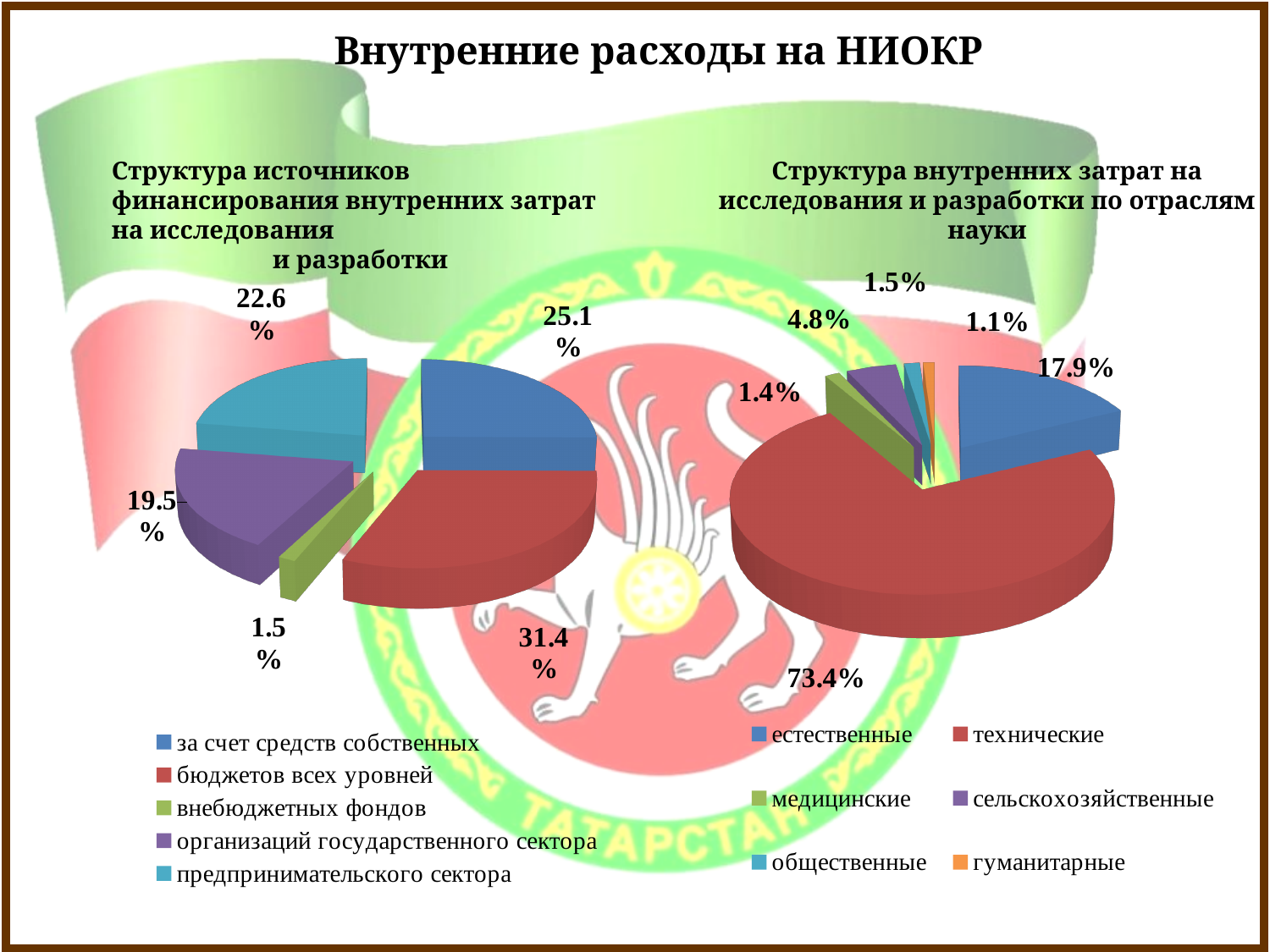
On the left chart (Структура источников финансирования), what is the difference between the shares of 'за счет средств собственных' and 'организаций государственного сектора'? 5.6% On the right chart (по отраслям науки), what share is attributed to 'естественные'? 17.9% On the right chart (по отраслям науки), which branch of science has the largest share? технические On the right chart (по отраслям науки), how many categories does the legend list? 6 On the left chart (Структура источников финансирования), which source has the smallest share? внебюджетных фондов What type of chart is used for both charts on the slide? Pie chart On the left chart (Структура источников финансирования), what share is attributed to 'бюджетов всех уровней'? 31.4% On the left chart (Структура источников финансирования), how many categories does the legend list? 5 On the right chart (по отраслям науки), which is larger: the share for 'сельскохозяйственные' or for 'медицинские'? сельскохозяйственные On the left chart (Структура источников финансирования), which source has the largest share? бюджетов всех уровней On the right chart (по отраслям науки), what share is attributed to 'технические'? 73.4% On the left chart (Структура источников финансирования), what share is attributed to 'предпринимательского сектора'? 22.6%